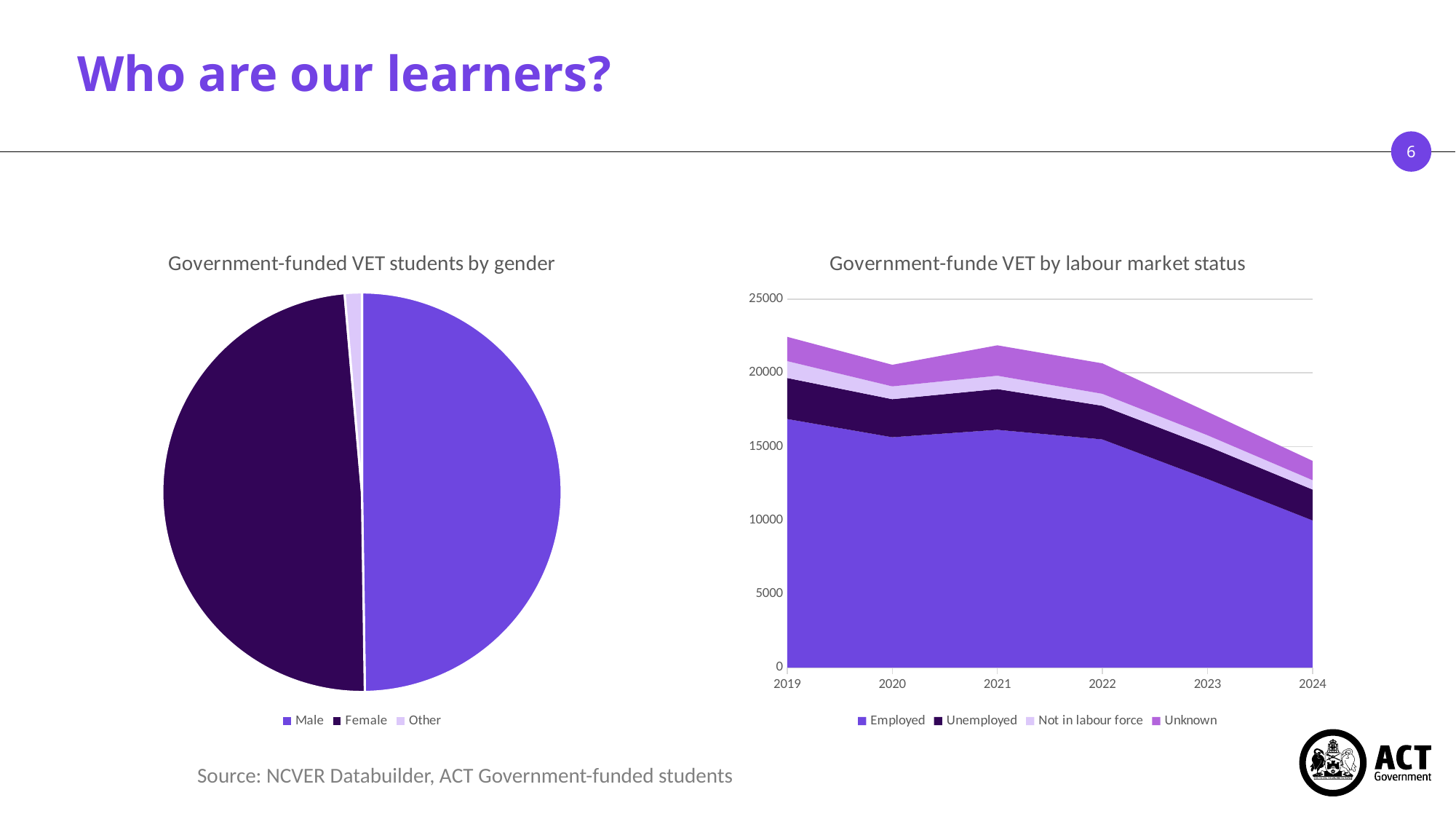
In the 'Government-funde VET by labour market status' chart, is the total of all series in 2019 greater or less than 20000? greater In the 'Government-funde VET by labour market status' chart, is the Employed value in 2019 greater or less than 15000? greater In the 'Government-funde VET by labour market status' chart, does the total of all series rise or fall from 2021 to 2024? fall What is the first year shown on the x axis of the 'Government-funde VET by labour market status' chart? 2019 What kind of chart is the 'Government-funde VET by labour market status' chart? area chart How many categories does the legend of the 'Government-funded VET students by gender' pie chart list? 3 In the 'Government-funde VET by labour market status' chart, is the total of all series in 2024 greater or less than 15000? less How many series does the legend of the 'Government-funde VET by labour market status' chart list? 4 How many years are shown on the x axis of the 'Government-funde VET by labour market status' chart? 6 In the 'Government-funded VET students by gender' pie chart, which category has the smallest slice? Other In the 'Government-funde VET by labour market status' chart, which series occupies the largest area? Employed What kind of chart is the 'Government-funded VET students by gender' chart? pie chart